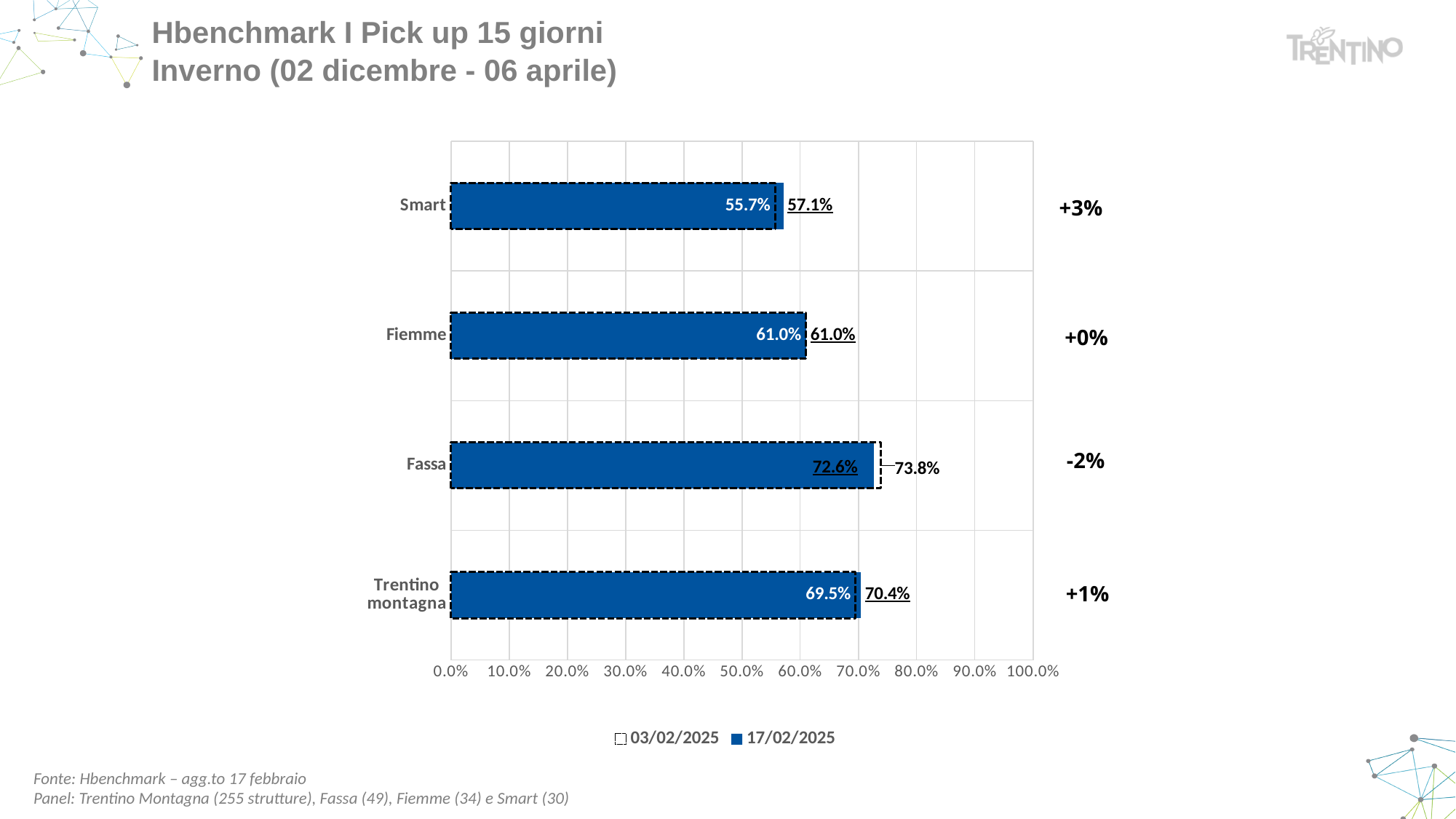
What percentage change is shown to the right of the Fassa bar? -2% Which category has the lowest value in the 03/02/2025 series? Smart How many series does the legend list? 2 What is the difference between the 17/02/2025 and 03/02/2025 values for Smart? 1.4% Is the 17/02/2025 value for Fiemme greater or less than 70.0%? less What is the value for Fassa in the 03/02/2025 series? 73.8% How many categories are shown on the chart? 4 What is the value for Smart in the 17/02/2025 series? 57.1% What is the value for Trentino montagna in the 17/02/2025 series? 70.4% Which category has the highest value in the 17/02/2025 series? Fassa What is the value for Fiemme in the 03/02/2025 series? 61.0% What kind of chart is shown on the slide? bar chart